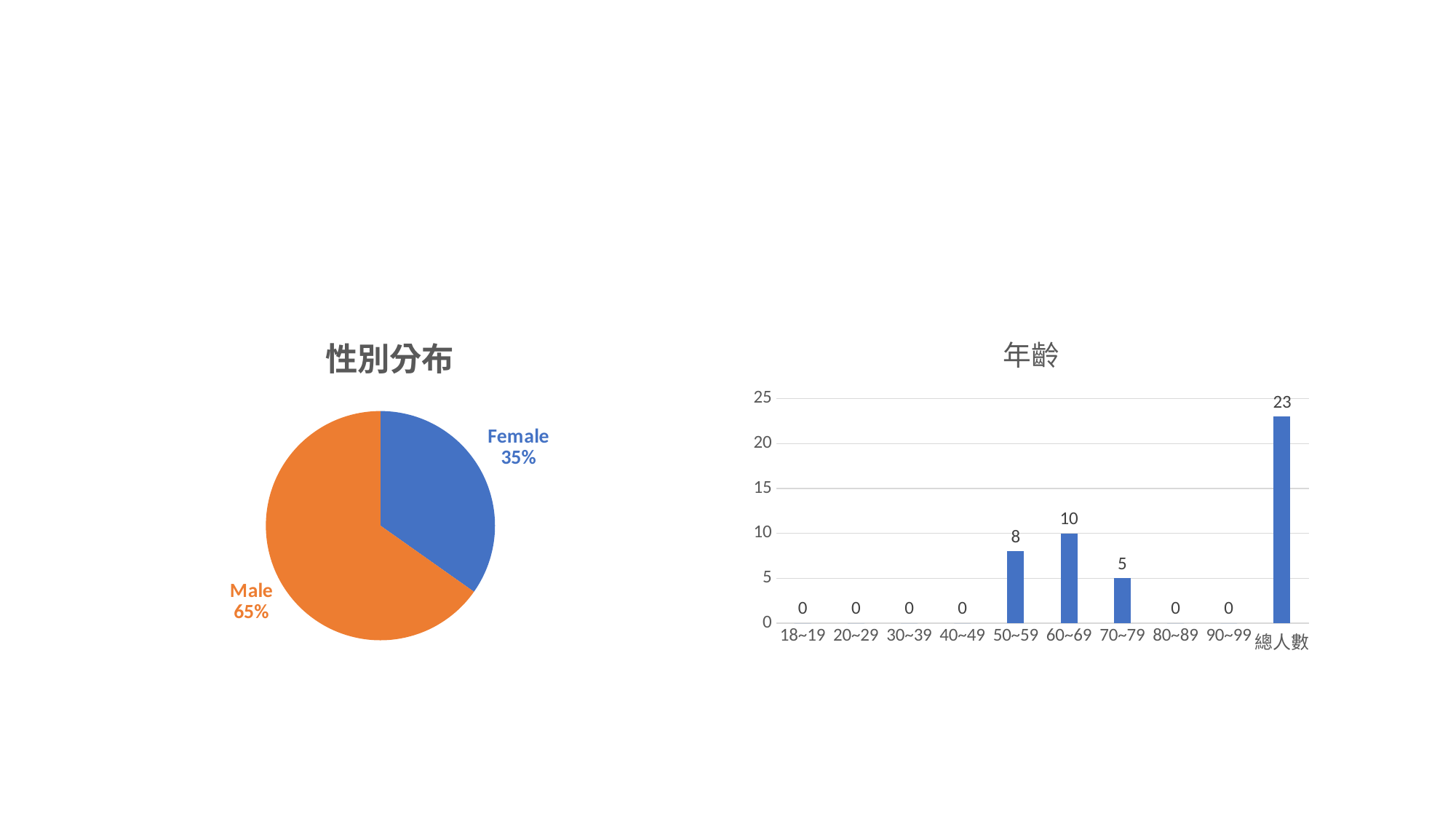
In the 年齡 chart, what is the value for 50~59? 8 In the 性別分布 pie chart, what colour is the Male slice? orange In the 性別分布 pie chart, what share is Male? 65% How many categories are shown on the x axis of the 年齡 chart? 10 In the 性別分布 pie chart, which slice is larger, Male or Female? Male In the 年齡 chart, which age group (excluding 總人數) has the highest value? 60~69 In the 性別分布 pie chart, what share is Female? 35% In the 年齡 chart, what is the difference between the values for 60~69 and 70~79? 5 In the 年齡 chart, what is the value for 總人數? 23 In the 年齡 chart, what is the value for 60~69? 10 What kind of chart is the 性別分布 chart? pie chart What kind of chart is the 年齡 chart? bar chart